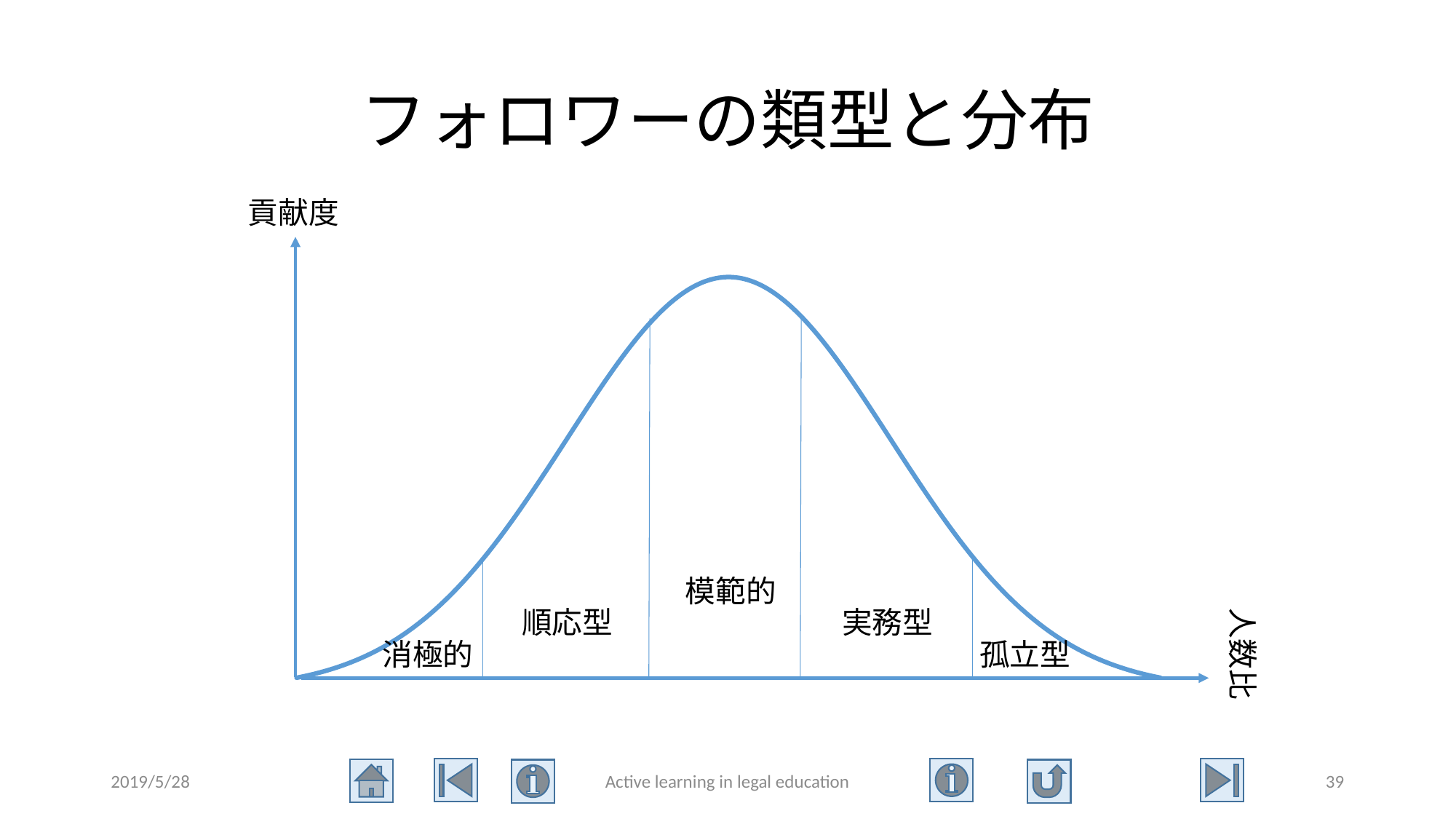
Does the curve rise or fall from the 模範的 section toward the right edge? fall How many follower categories are labelled along the x axis of the chart? 5 Which section of the curve is higher, 実務型 or 孤立型? 実務型 What is the title of the chart on the slide? フォロワーの類型と分布 What is the label of the vertical axis? 貢献度 Which category lies between 順応型 and 実務型 on the x axis? 模範的 What kind of chart is shown on the slide? line chart (bell curve) Does the curve rise or fall from the left edge toward the 模範的 section? rise Which category is labelled at the far right of the x axis? 孤立型 Which category is labelled at the far left of the x axis? 消極的 Which follower category sits under the peak of the curve? 模範的 Which section of the curve is higher, 順応型 or 消極的? 順応型